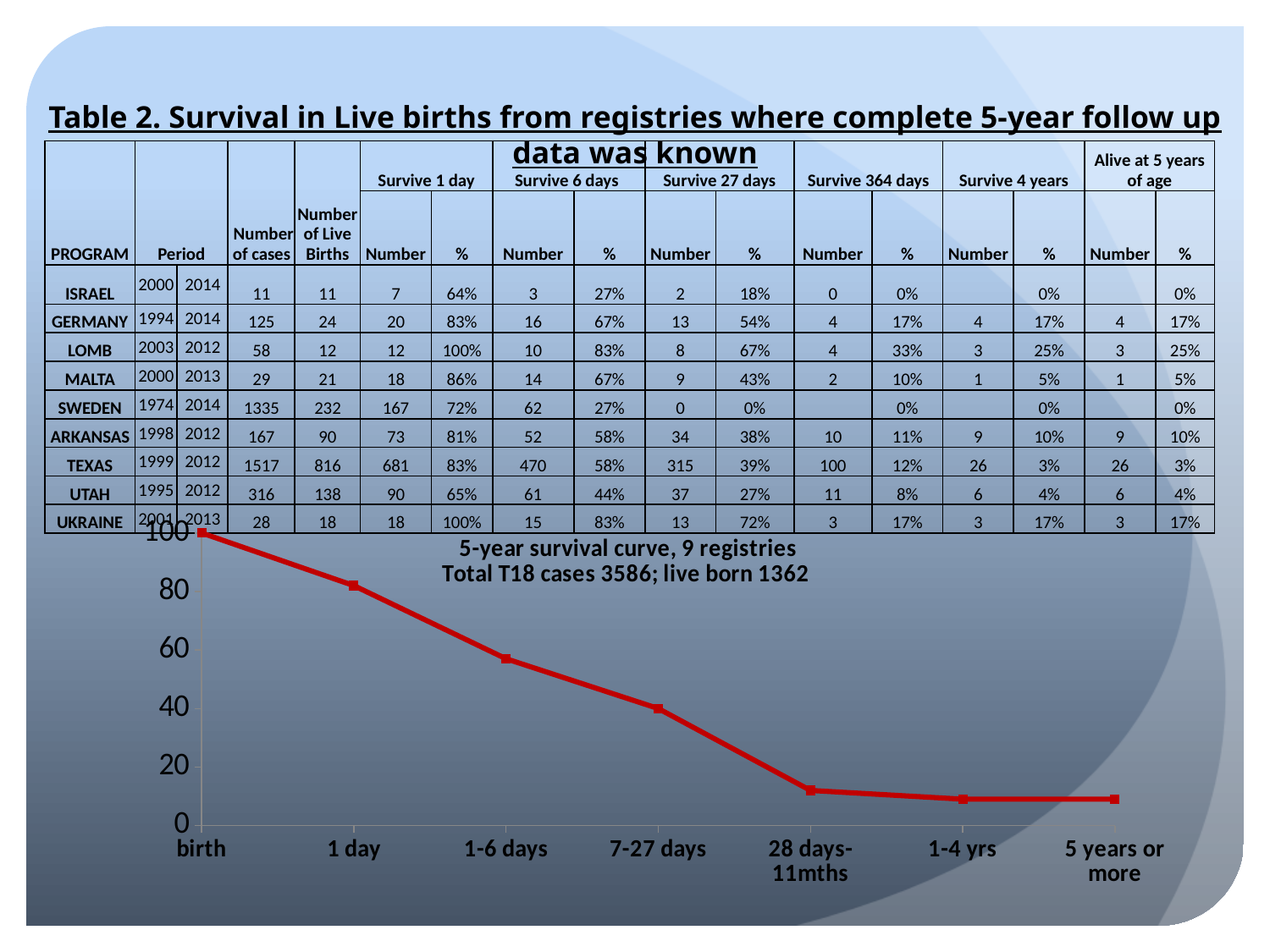
In the survival curve chart, is the value for 28 days-11mths greater or less than 20? less In the survival curve chart, is the value for 1-6 days greater or less than 60? less What kind of chart is shown below the table on the slide? line chart What colour is the line in the survival curve chart? red In the survival curve chart, what is the value at birth? 100 How many points are plotted along the x axis of the survival curve chart? 7 In the survival curve chart, which is larger, the value for 1 day or the value for 7-27 days? 1 day In the survival curve chart, which x-axis category has the lowest value? 1-4 yrs and 5 years or more (tied) In the survival curve chart, do the values rise or fall from birth to 5 years or more? fall What is the title of the chart below the table? 5-year survival curve, 9 registries Total T18 cases 3586; live born 1362 In the survival curve chart, which x-axis category has the highest value? birth